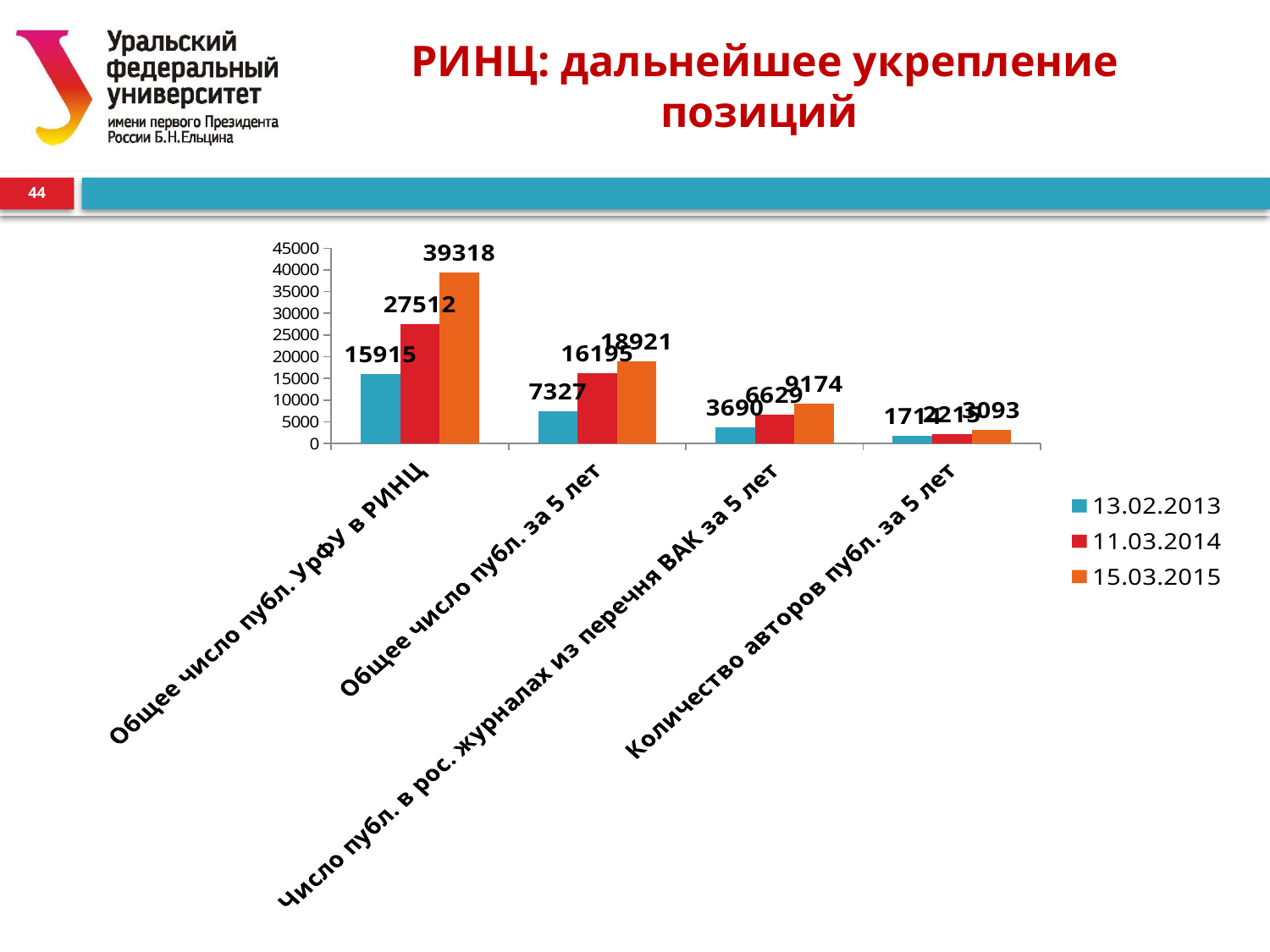
Is the 11.03.2014 value for 'Общее число публ. за 5 лет' greater or less than 15000? greater What is the difference between the 11.03.2014 and 13.02.2013 values for 'Число публ. в рос. журналах из перечня ВАК за 5 лет'? 2939 What is the difference between the 15.03.2015 and 11.03.2014 values for 'Общее число публ. УрФУ в РИНЦ'? 11806 Which category has the lowest value in the 13.02.2013 series? Количество авторов публ. за 5 лет Which is larger: the 13.02.2013 value for 'Общее число публ. за 5 лет' or the 15.03.2015 value for 'Число публ. в рос. журналах из перечня ВАК за 5 лет'? 15.03.2015 value for 'Число публ. в рос. журналах из перечня ВАК за 5 лет' Which category has the highest value in the 15.03.2015 series? Общее число публ. УрФУ в РИНЦ What is the value for 'Общее число публ. УрФУ в РИНЦ' in the 13.02.2013 series? 15915 What kind of chart is shown on the slide? Bar chart What is the value for 'Число публ. в рос. журналах из перечня ВАК за 5 лет' in the 15.03.2015 series? 9174 What is the value for 'Общее число публ. за 5 лет' in the 13.02.2013 series? 7327 How many series does the legend list? 3 What is the value for 'Общее число публ. УрФУ в РИНЦ' in the 15.03.2015 series? 39318